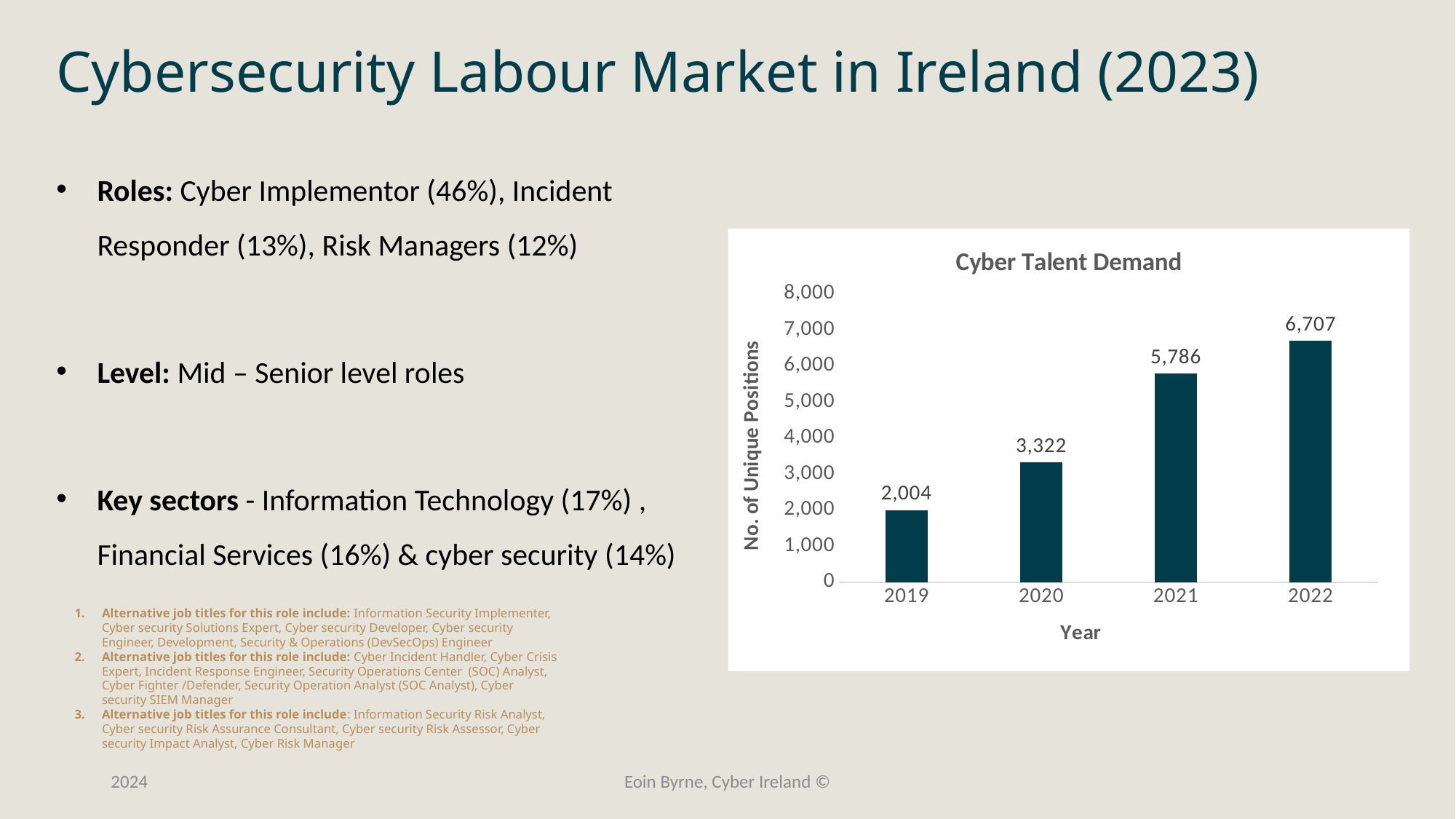
Which year has the highest number of unique positions in the Cyber Talent Demand chart? 2022 Which year has the lowest number of unique positions in the Cyber Talent Demand chart? 2019 What is the number of unique positions for 2022 in the Cyber Talent Demand chart? 6,707 What type of chart is the Cyber Talent Demand chart? bar chart What is the number of unique positions for 2019 in the Cyber Talent Demand chart? 2,004 Is the value for 2020 in the Cyber Talent Demand chart greater or less than 3,000? greater What is the difference in unique positions between 2022 and 2021 in the Cyber Talent Demand chart? 921 Which year has more unique positions in the Cyber Talent Demand chart, 2020 or 2021? 2021 What is the number of unique positions for 2021 in the Cyber Talent Demand chart? 5,786 Do the values in the Cyber Talent Demand chart rise or fall from 2019 to 2022? rise What is the difference in unique positions between 2020 and 2019 in the Cyber Talent Demand chart? 1,318 How many years are shown on the x axis of the Cyber Talent Demand chart? 4